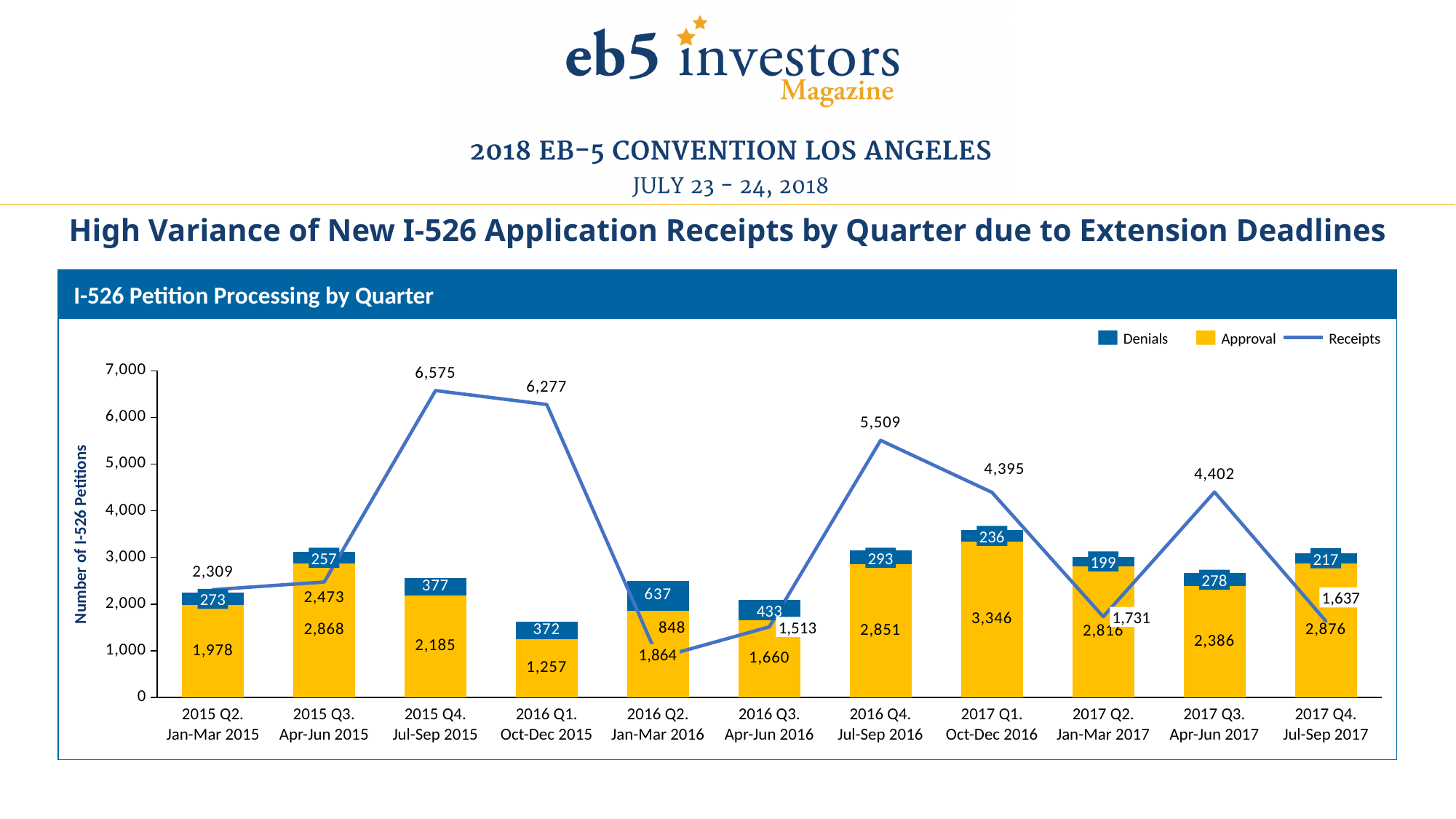
How many series does the legend list? 3 How many quarters are shown on the x axis? 11 What kind of chart is this? Combination stacked bar and line chart What is the Receipts value for 2015 Q4 (Jul-Sep 2015)? 6,575 Which quarter has more Denials, 2016 Q3 or 2016 Q4? 2016 Q3 What is the total of the stacked bar (Approval plus Denials) for 2017 Q1 (Oct-Dec 2016)? 3,582 What is the Approval value for 2017 Q1 (Oct-Dec 2016)? 3,346 What is the difference between the Receipts values for 2015 Q4 and 2016 Q1? 298 Which quarter has the lowest Receipts value? 2016 Q2 (Jan-Mar 2016) What is the Denials value for 2016 Q2 (Jan-Mar 2016)? 637 Which quarter has the highest Receipts value? 2015 Q4 (Jul-Sep 2015) Which quarter has the lowest Approval value? 2016 Q1 (Oct-Dec 2015)